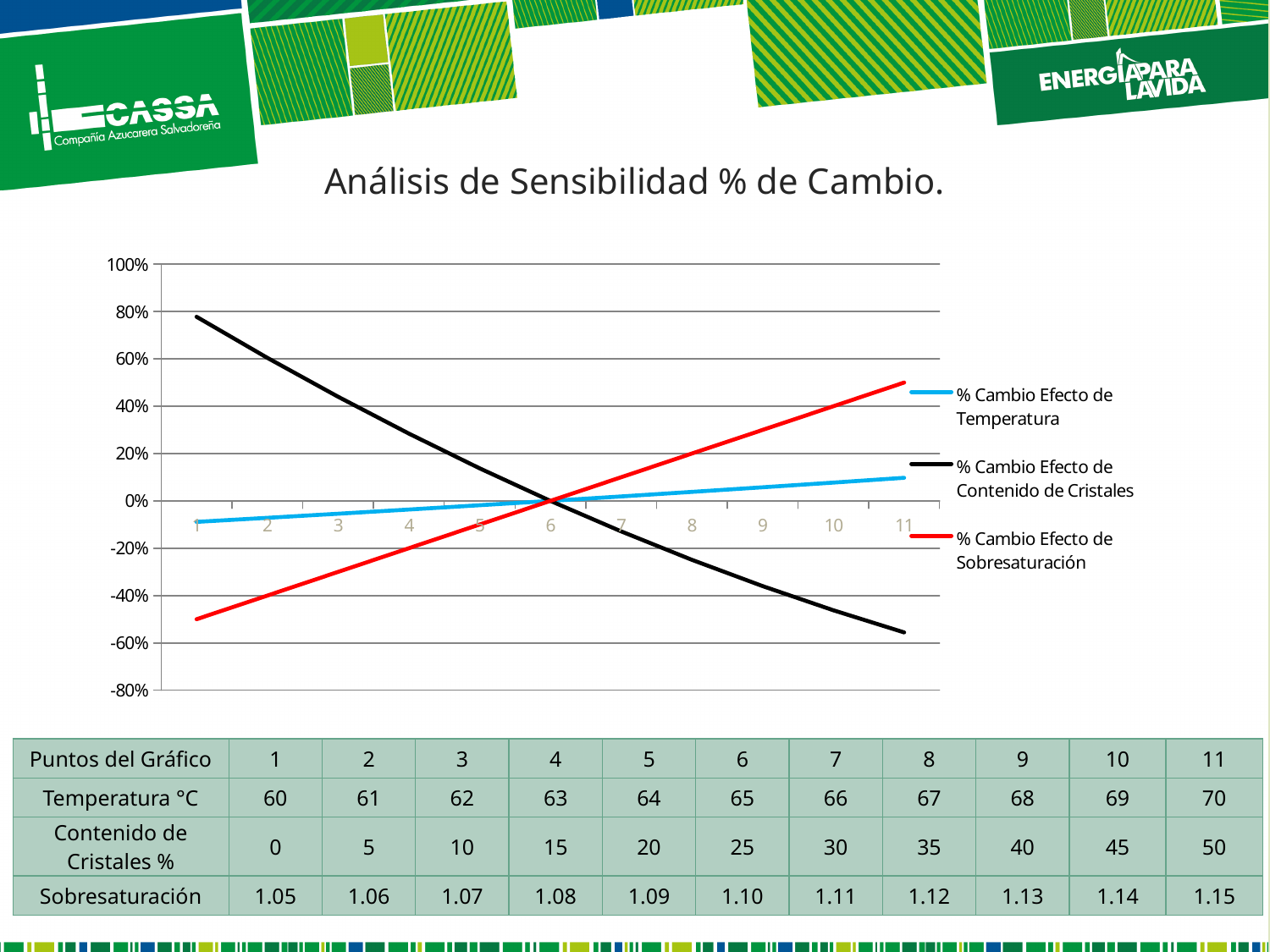
At point 11, which is larger: '% Cambio Efecto de Sobresaturación' or '% Cambio Efecto de Temperatura'? % Cambio Efecto de Sobresaturación How many series does the chart legend list? 3 Which series has the highest value at point 1? % Cambio Efecto de Contenido de Cristales How many points are plotted along the x axis of the chart? 11 Is the value of '% Cambio Efecto de Contenido de Cristales' at point 11 greater or less than -40%? less Which series has the lowest value at point 11? % Cambio Efecto de Contenido de Cristales Does the '% Cambio Efecto de Contenido de Cristales' line rise or fall from point 1 to point 11? fall Is the value of '% Cambio Efecto de Sobresaturación' at point 1 greater or less than -40%? less Is the value of '% Cambio Efecto de Contenido de Cristales' at point 1 greater or less than 60%? greater What kind of chart is shown on the slide? line chart What is the title of the slide above the chart? Análisis de Sensibilidad % de Cambio. Does the '% Cambio Efecto de Sobresaturación' line rise or fall from point 1 to point 11? rise